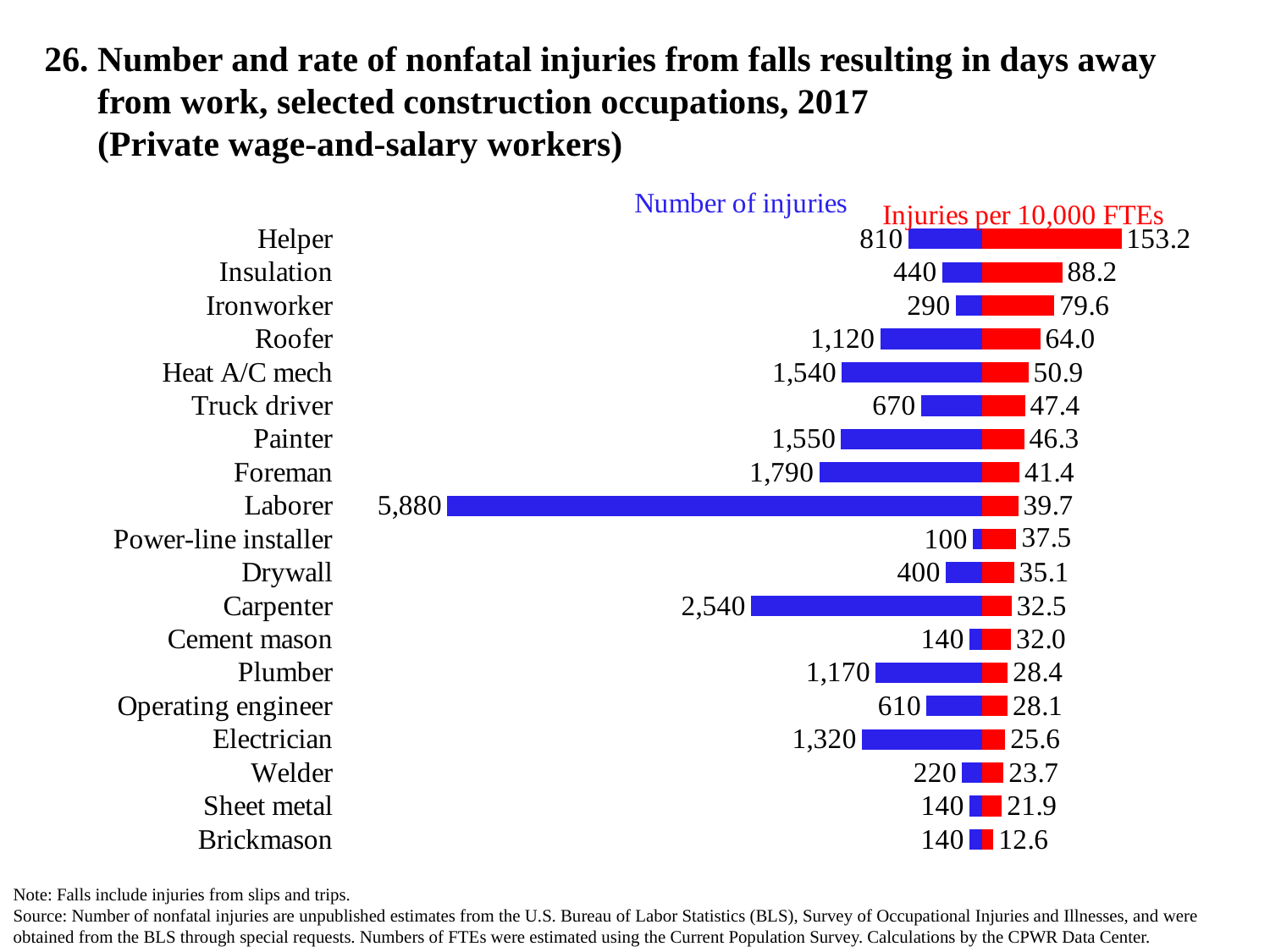
How many occupations are shown in the chart? 19 What is the difference in number of injuries between Laborer and Carpenter? 3,340 What is the number of injuries for Carpenter? 2,540 Which occupation has the lowest injuries per 10,000 FTEs rate? Brickmason Which has a higher number of injuries, Roofer or Plumber? Plumber What is the injuries per 10,000 FTEs rate for Brickmason? 12.6 Which occupation has the highest number of injuries? Laborer What is the injuries per 10,000 FTEs rate for Helper? 153.2 What is the number of injuries for Laborer? 5,880 What type of chart is shown on the slide? Bar chart What is the difference in injuries per 10,000 FTEs between Helper and Insulation? 65.0 Which occupation has the lowest number of injuries? Power-line installer